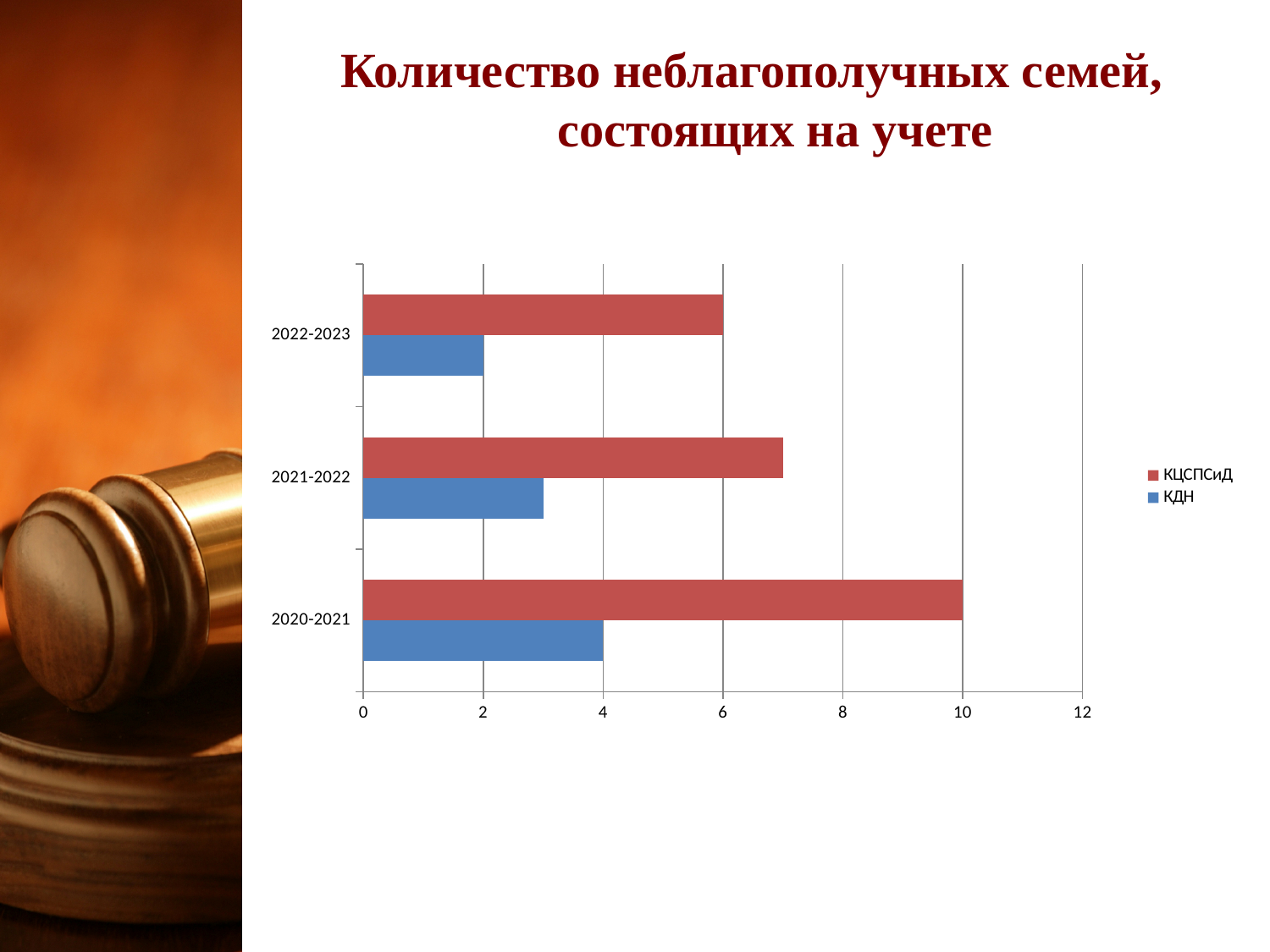
What kind of chart is shown on the slide? bar chart What is the value for КДН in 2020-2021? 4 In which period is the КЦСПСиД value highest? 2020-2021 Is the value for КДН in 2021-2022 greater or less than 4? less What is the difference between the КЦСПСиД and КДН values in 2020-2021? 6 What is the value for КДН in 2022-2023? 2 How many categories (periods) are shown on the chart? 3 What is the value for КЦСПСиД in 2022-2023? 6 What is the value for КЦСПСиД in 2020-2021? 10 How many series does the legend list? 2 Is the value for КЦСПСиД in 2021-2022 greater or less than 6? greater Which series is shown in red? КЦСПСиД